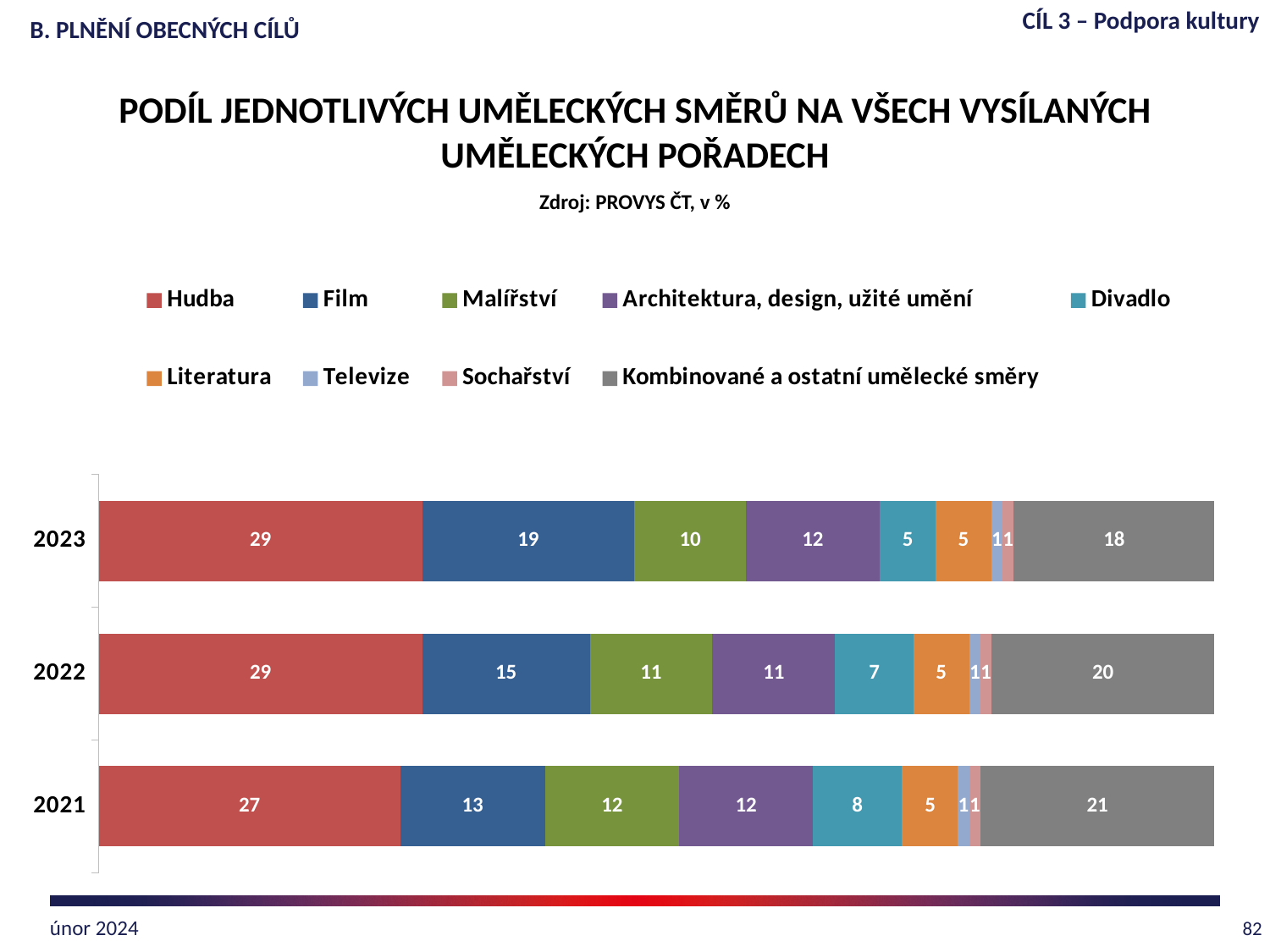
What kind of chart is shown on the slide? Stacked bar chart What is the value for Divadlo in 2021? 8 Does the value for Kombinované a ostatní umělecké směry rise or fall from 2021 to 2023? Fall What is the value for Film in 2022? 15 How many years (bars) are shown in the chart? 3 Which series has the highest value in the 2023 bar? Hudba What is the value for Kombinované a ostatní umělecké směry in 2021? 21 What is the total of the 2022 stacked bar? 100 What is the value for Hudba in 2023? 29 How many series does the legend list? 9 What is the difference between the Film values for 2023 and 2021? 6 Which is larger: Malířství in 2022 or Malířství in 2023? Malířství in 2022